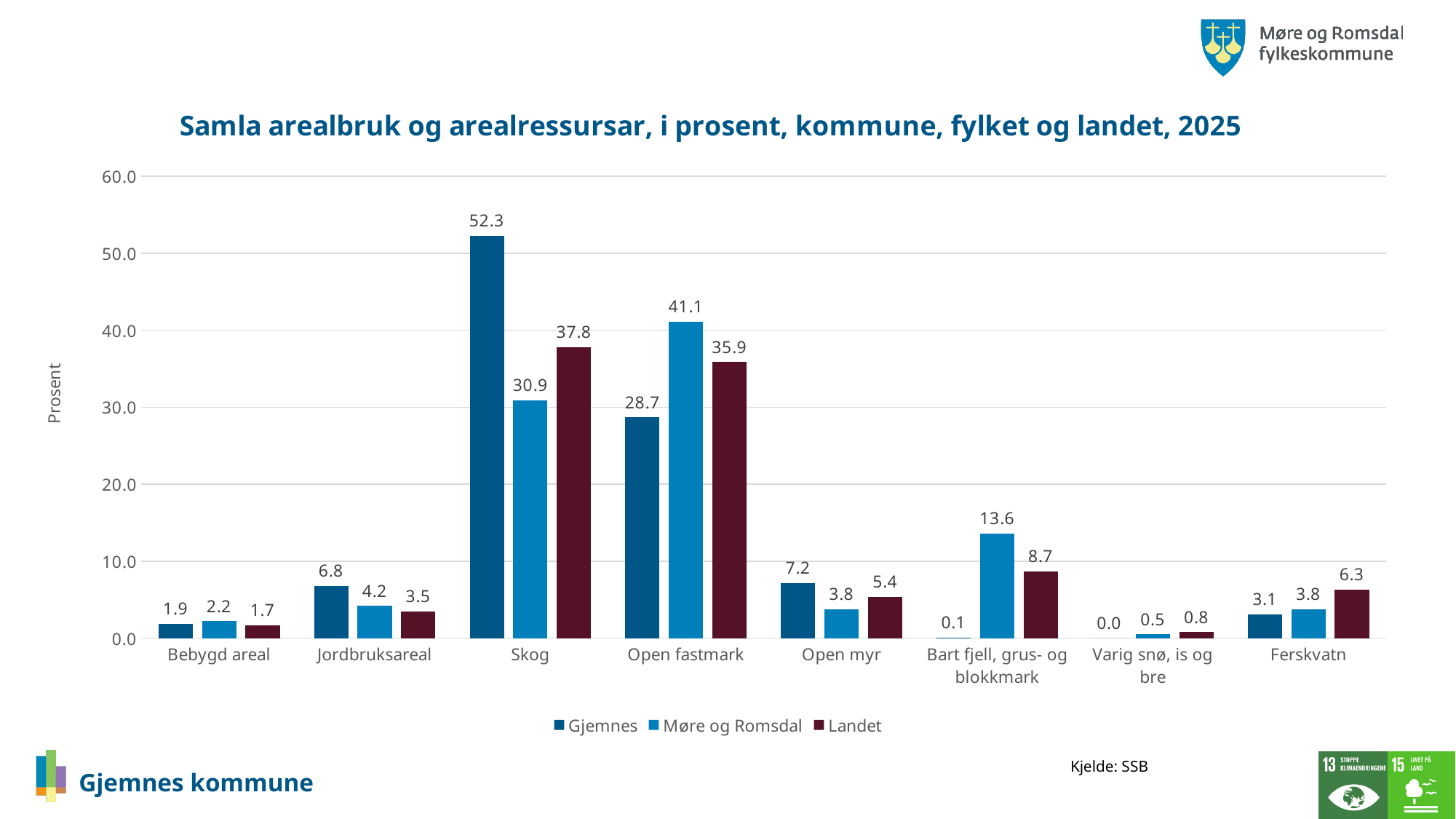
Which category has the highest value for Gjemnes? Skog What kind of chart is shown on the slide? Bar chart Is the value for Gjemnes in Open fastmark greater or less than 30.0? less What is the difference between the Gjemnes and Landet values for Skog? 14.5 How many categories are shown on the x axis? 8 What is the value for Gjemnes in the Skog category? 52.3 Which is larger in the Bart fjell, grus- og blokkmark category: Møre og Romsdal or Landet? Møre og Romsdal How many series does the legend list? 3 What is the value for Møre og Romsdal in the Open fastmark category? 41.1 Which category has the lowest value for Møre og Romsdal? Varig snø, is og bre What is the title of the chart? Samla arealbruk og arealressursar, i prosent, kommune, fylket og landet, 2025 What is the value for Landet in the Ferskvatn category? 6.3